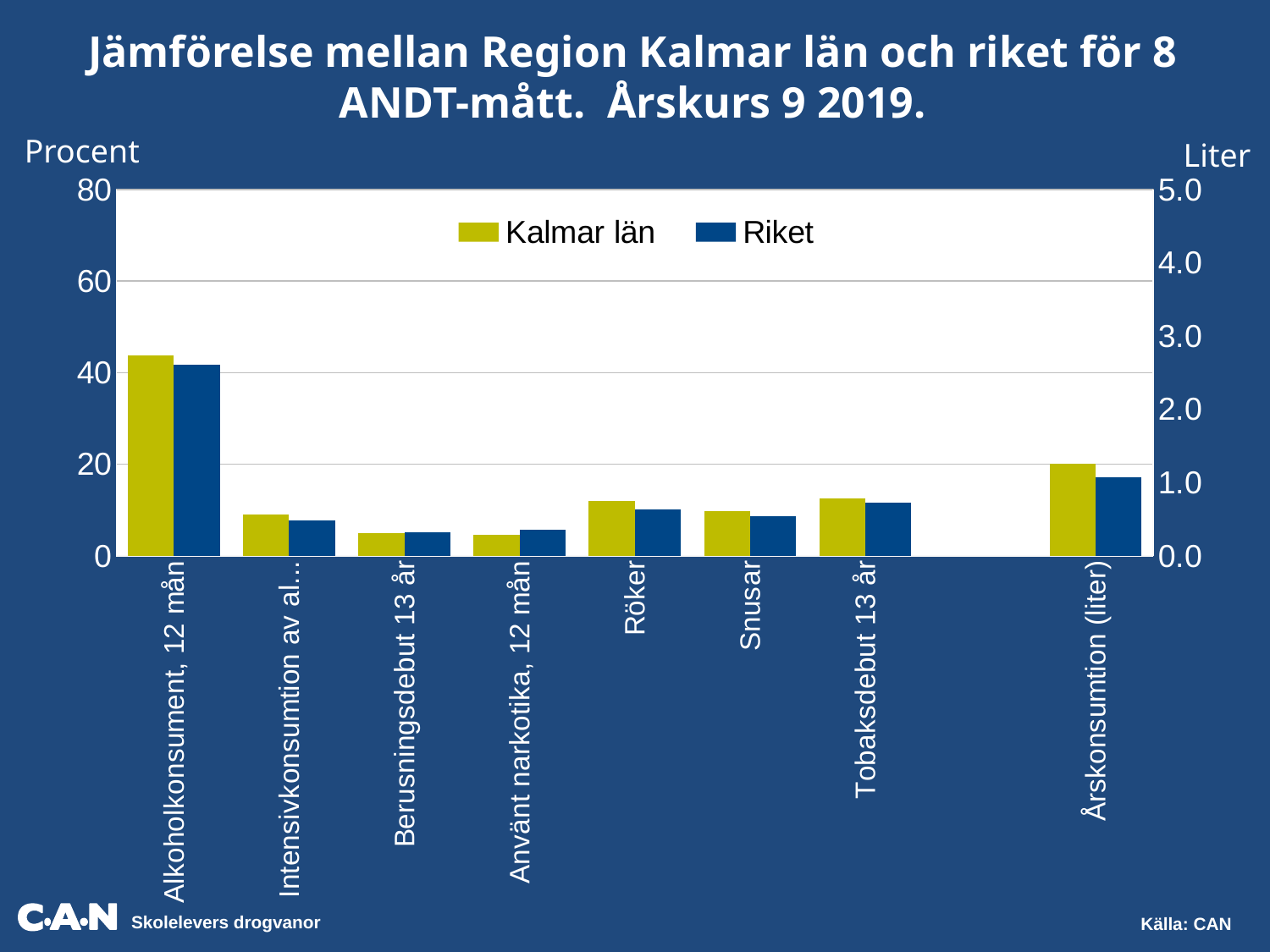
Is the Kalmar län value for Alkoholkonsument, 12 mån greater or less than 40? greater Is the Kalmar län value for Årskonsumtion (liter) greater or less than 1.0 on the right axis? greater For Använt narkotika, 12 mån, which is larger: Kalmar län or Riket? Riket Which category has the highest value for Riket? Alkoholkonsument, 12 mån Which category has the highest value for Kalmar län? Alkoholkonsument, 12 mån How many categories are shown on the x axis? 8 How many series does the legend list? 2 What kind of chart is shown on the slide? bar chart What unit is shown on the right-hand axis? Liter Is the Kalmar län value for Alkoholkonsument, 12 mån greater or less than 60? less For Alkoholkonsument, 12 mån, which is larger: Kalmar län or Riket? Kalmar län